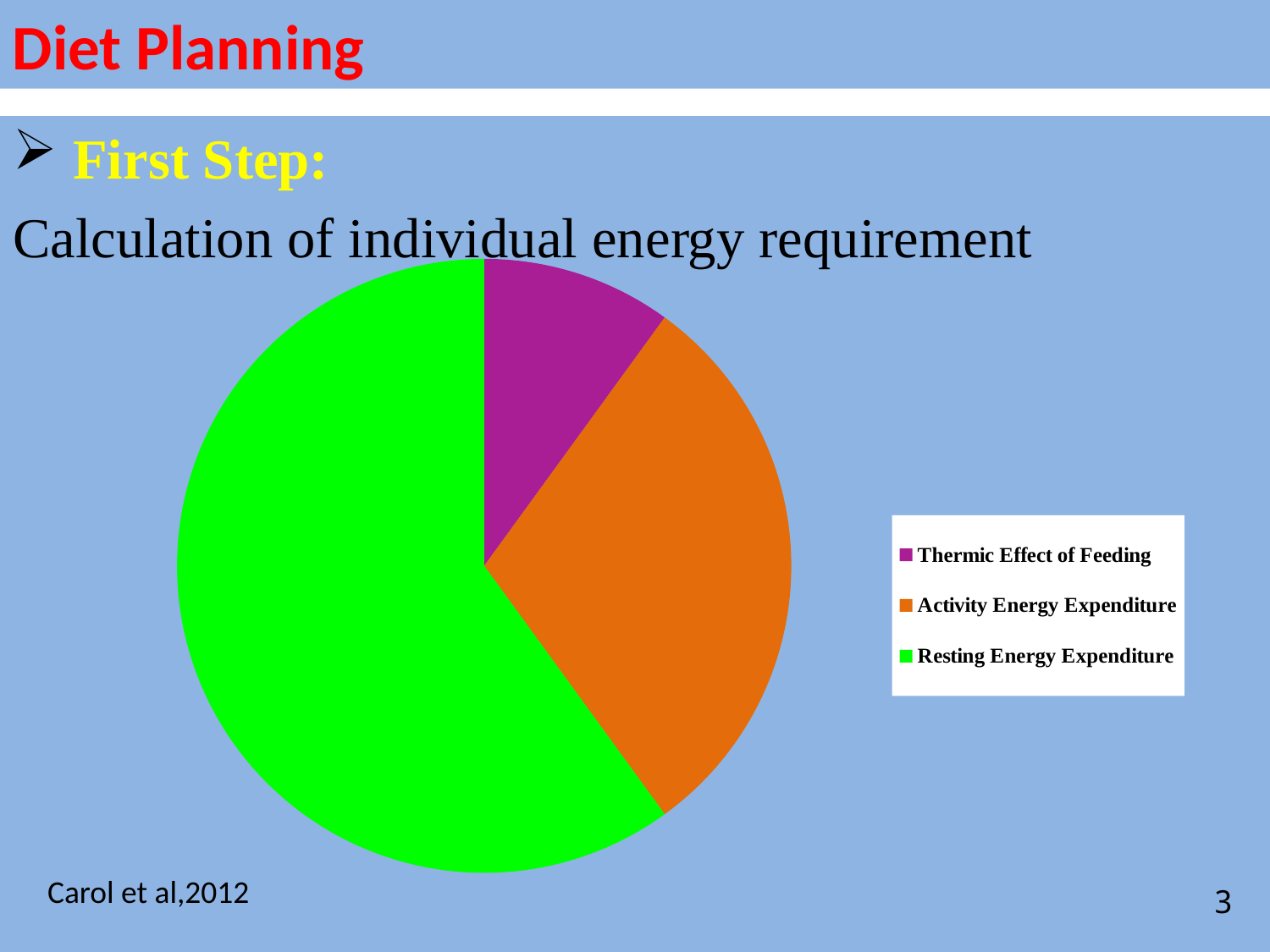
Which category is shown in orange in the pie chart? Activity Energy Expenditure Which colour represents Resting Energy Expenditure in the pie chart? green Which category has the smallest slice of the pie chart? Thermic Effect of Feeding Which slice is larger: Resting Energy Expenditure or Activity Energy Expenditure? Resting Energy Expenditure What kind of chart is shown on the slide? pie chart How many slices does the pie chart have? 3 Which slice is larger: Activity Energy Expenditure or Thermic Effect of Feeding? Activity Energy Expenditure How many entries does the legend of the pie chart list? 3 Which category has the largest slice of the pie chart? Resting Energy Expenditure